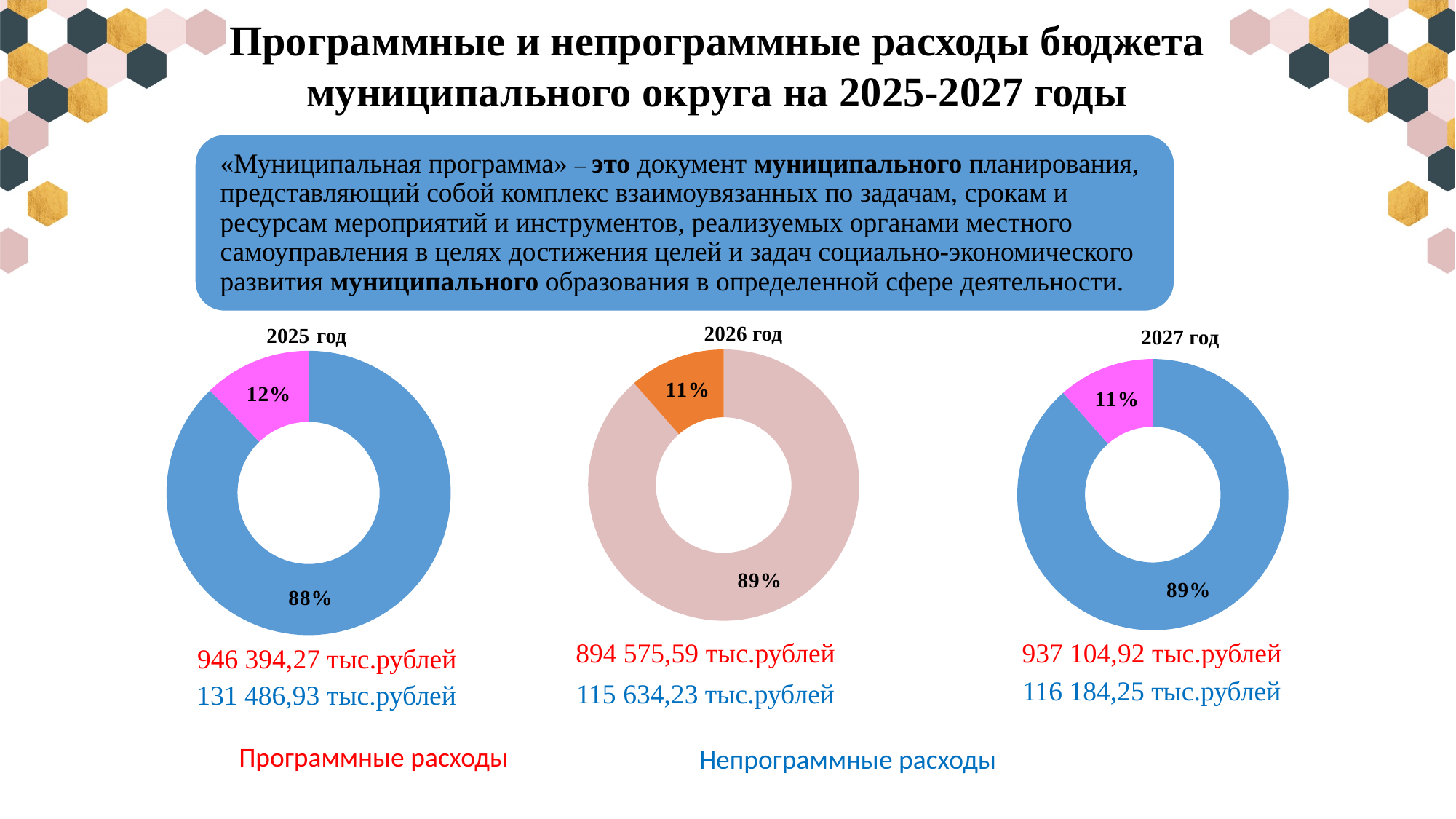
In the 2025 год chart, what share is labelled on the smaller slice? 12% What kind of chart is used for each of the three years on the slide? Doughnut (pie) chart In the 2025 год chart, what share is labelled on the larger slice? 88% What amount of Программные расходы is printed under the 2027 год chart? 937 104,92 тыс.рублей In the 2026 год chart, what share is labelled on the larger slice? 89% In the 2025 год chart, what is the difference in percentage points between the larger and smaller slices? 76 percentage points How many charts are shown on the slide? 3 How many slices does each doughnut chart contain? 2 What amount of Непрограммные расходы is printed under the 2026 год chart? 115 634,23 тыс.рублей Which two expense categories are named in the legend at the bottom of the slide? Программные расходы and Непрограммные расходы What amount of Программные расходы is printed under the 2025 год chart? 946 394,27 тыс.рублей